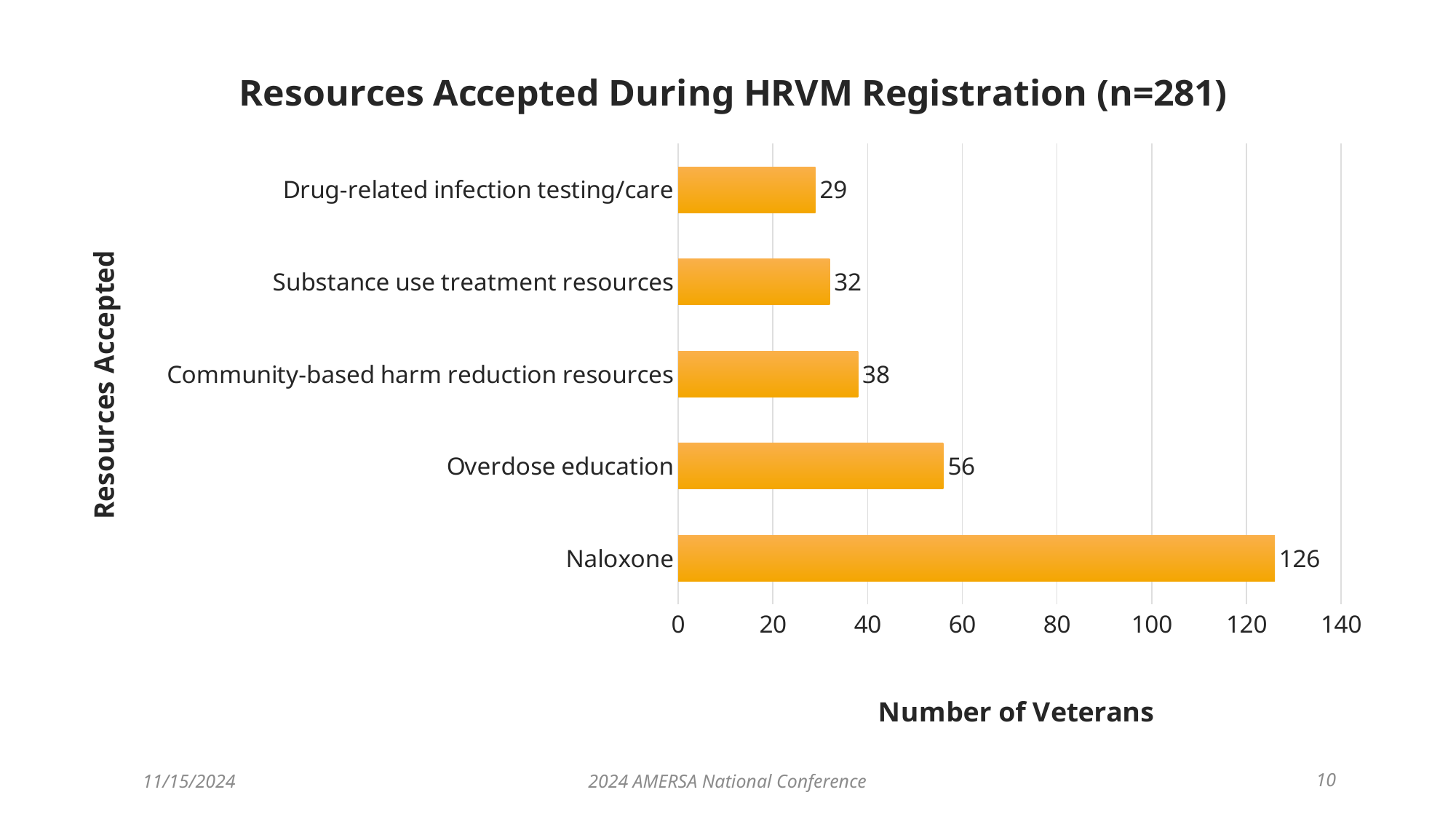
How many veterans accepted Naloxone? 126 What is the title of the chart? Resources Accepted During HRVM Registration (n=281) Which resource was accepted by the most veterans? Naloxone What is the value for Drug-related infection testing/care? 29 Which has a higher value: Community-based harm reduction resources or Substance use treatment resources? Community-based harm reduction resources What is the difference between the number of veterans who accepted Naloxone and those who accepted Overdose education? 70 What is the value for Overdose education? 56 Is the value for Naloxone greater or less than 120? greater What kind of chart is shown on the slide? bar chart How many resource categories are shown in the chart? 5 How many veterans accepted Substance use treatment resources? 32 Which resource was accepted by the fewest veterans? Drug-related infection testing/care